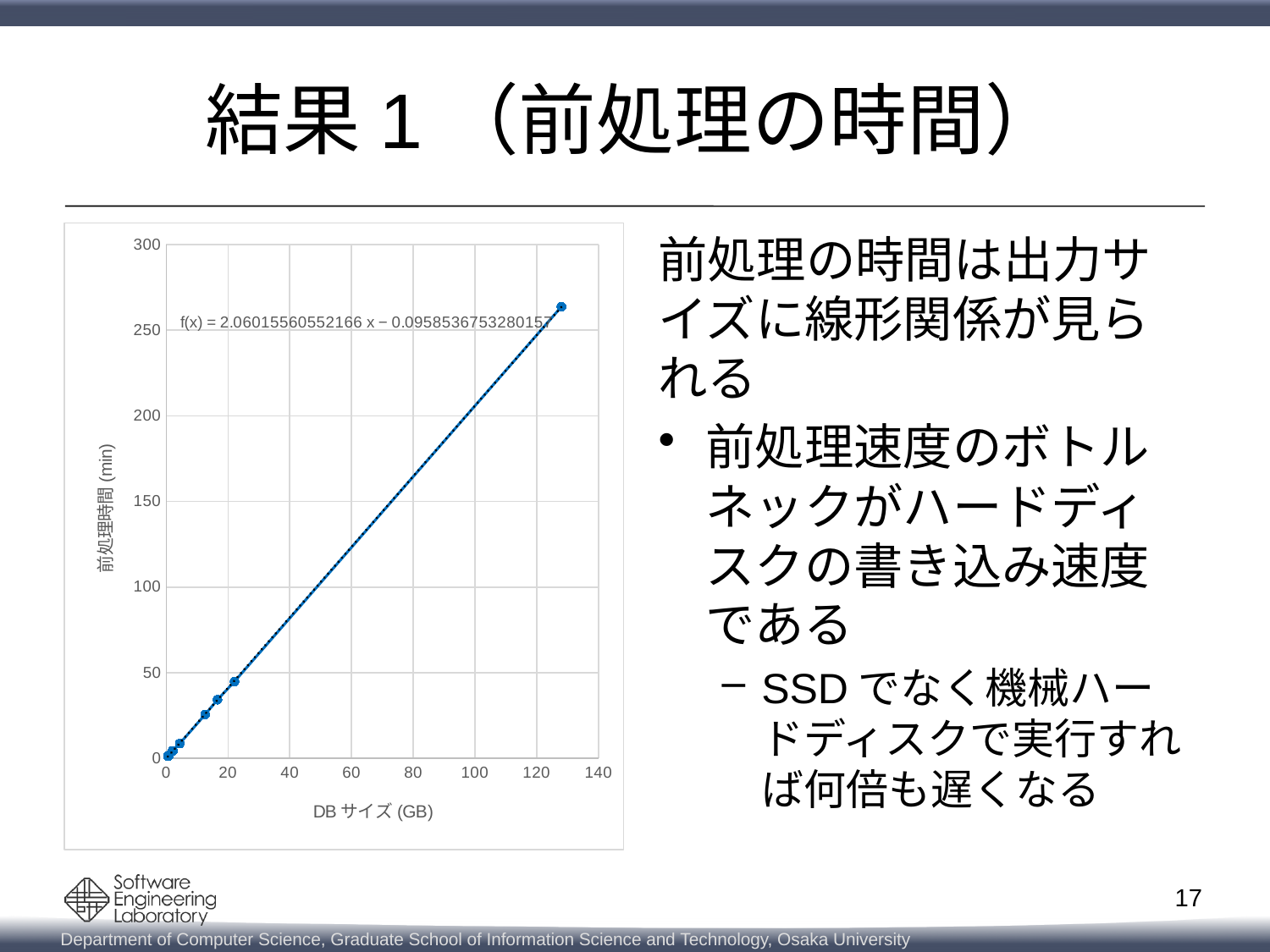
Is the preprocessing time for the point at about 22 GB greater or less than 50 min? less Is the preprocessing time for the largest DB size (around 128 GB) greater or less than 250 min? greater Which plotted point has the highest preprocessing time: the one at about 128 GB or the one at about 22 GB? the one at about 128 GB What kind of chart is shown on the slide? scatter chart Is the preprocessing time for the largest DB size (around 128 GB) greater or less than 300 min? less Do the plotted values rise or fall as DB size increases along the x axis? rise What is the label of the x axis of the chart? DB サイズ (GB) What is the label of the y axis of the chart? 前処理時間 (min) What is the maximum value shown on the y axis of the chart? 300